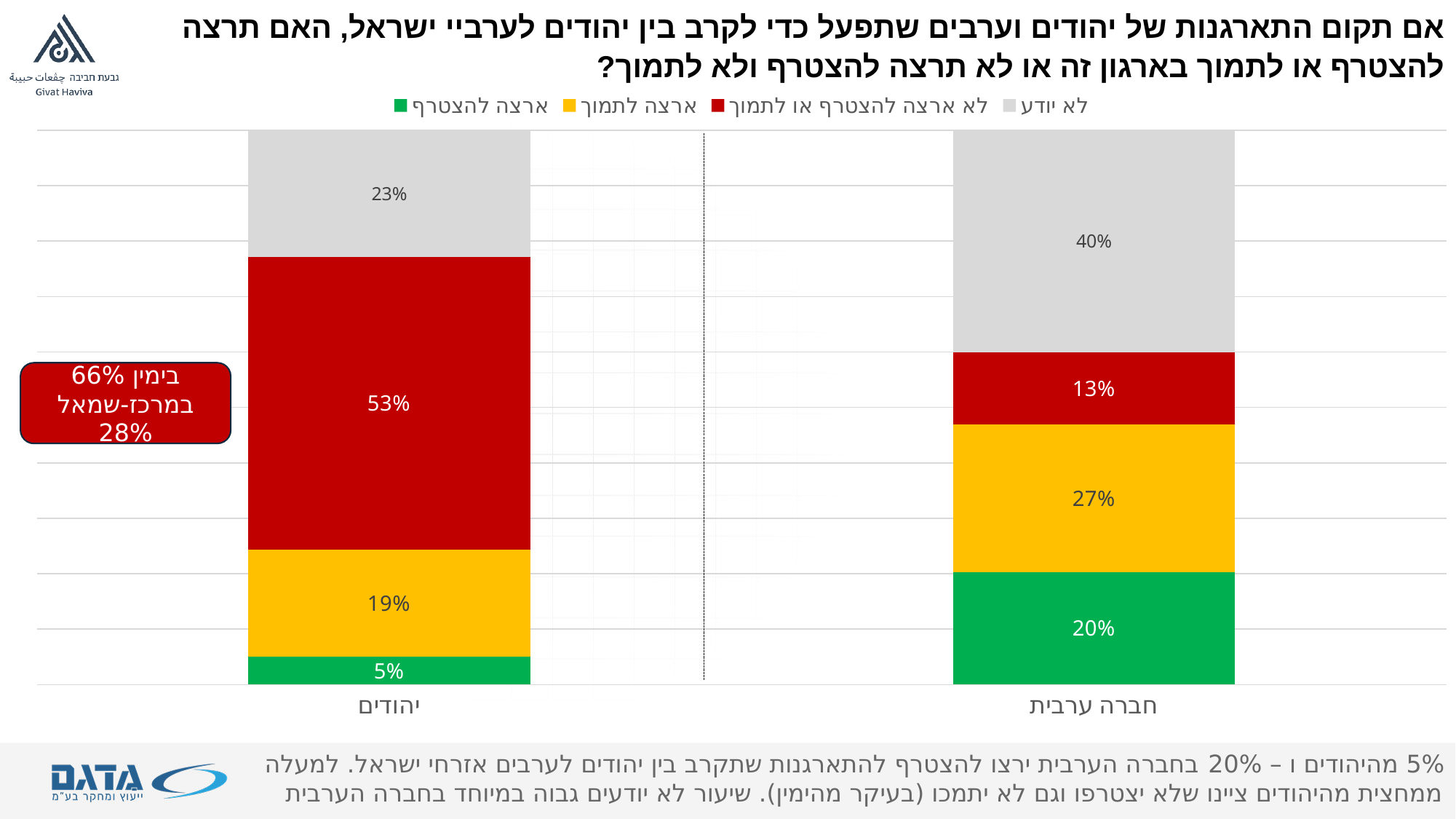
What percentage of חברה ערבית answered ארצה לתמוך? 27% Which category has the higher value for ארצה להצטרף, יהודים or חברה ערבית? חברה ערבית What percentage of חברה ערבית answered לא יודע? 40% How many series does the legend list? 4 What percentage of יהודים answered לא ארצה להצטרף או לתמוך? 53% Which response is the largest segment in the יהודים bar? לא ארצה להצטרף או לתמוך What is the difference between the ארצה להצטרף values for חברה ערבית and יהודים? 15% Which response is the smallest segment in the חברה ערבית bar? לא ארצה להצטרף או לתמוך Which category has the higher value for לא ארצה להצטרף או לתמוך, יהודים or חברה ערבית? יהודים What is the difference between the לא יודע values for חברה ערבית and יהודים? 17% What type of chart is shown on the slide? Stacked bar chart What percentage of יהודים answered ארצה להצטרף? 5%